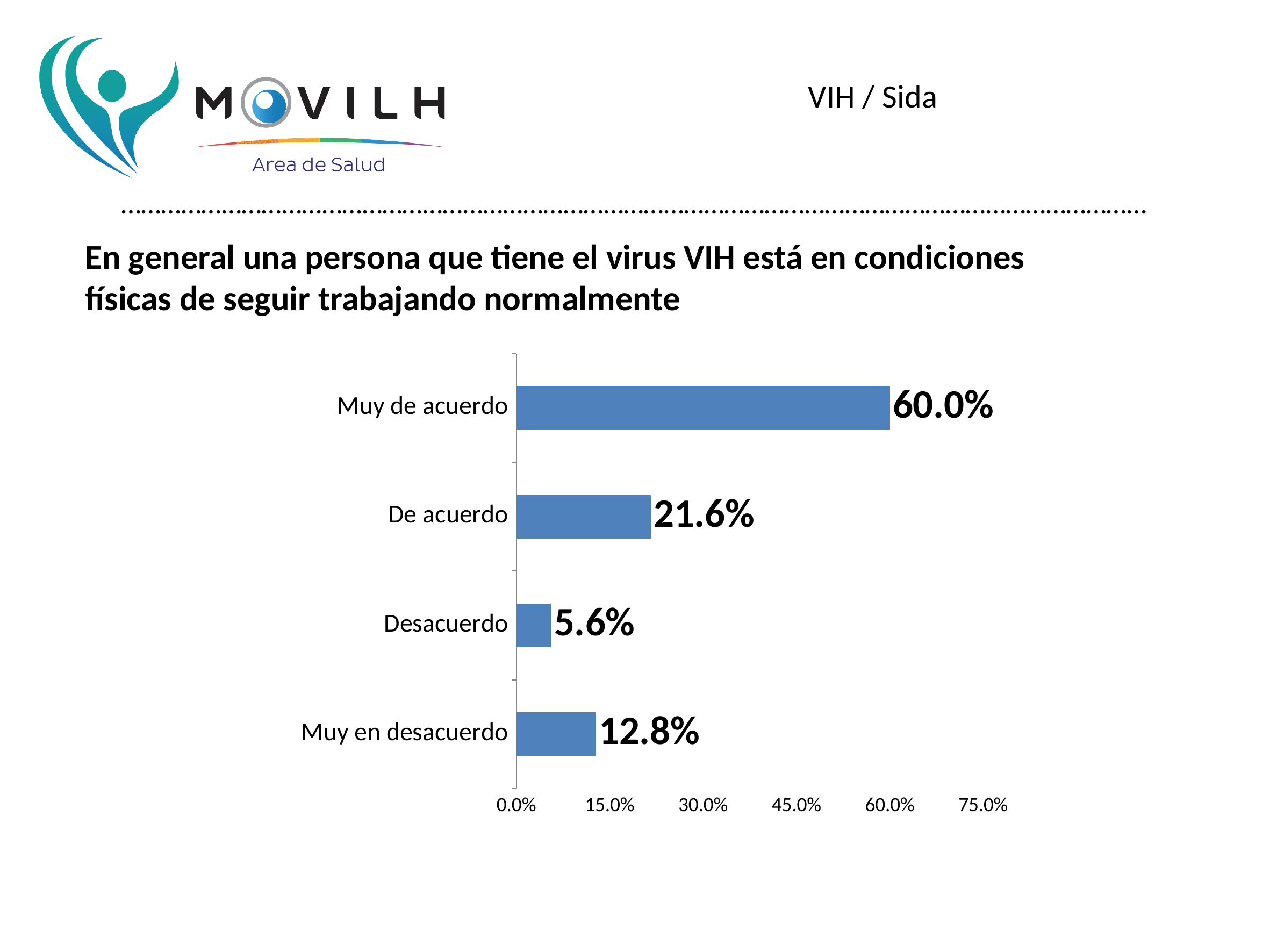
What is the difference between the values for Muy de acuerdo and De acuerdo? 38.4% What is the value for De acuerdo? 21.6% What is the value for Muy en desacuerdo? 12.8% Which category has the lowest value? Desacuerdo What is the value for Desacuerdo? 5.6% What kind of chart is shown on the slide? Bar chart How many categories are shown in the chart? 4 Which is larger, the value for De acuerdo or the value for Muy en desacuerdo? De acuerdo What is the value for Muy de acuerdo? 60.0% What is the difference between the values for Muy en desacuerdo and Desacuerdo? 7.2% Which category has the highest value? Muy de acuerdo Is the value for De acuerdo greater or less than 15.0%? greater